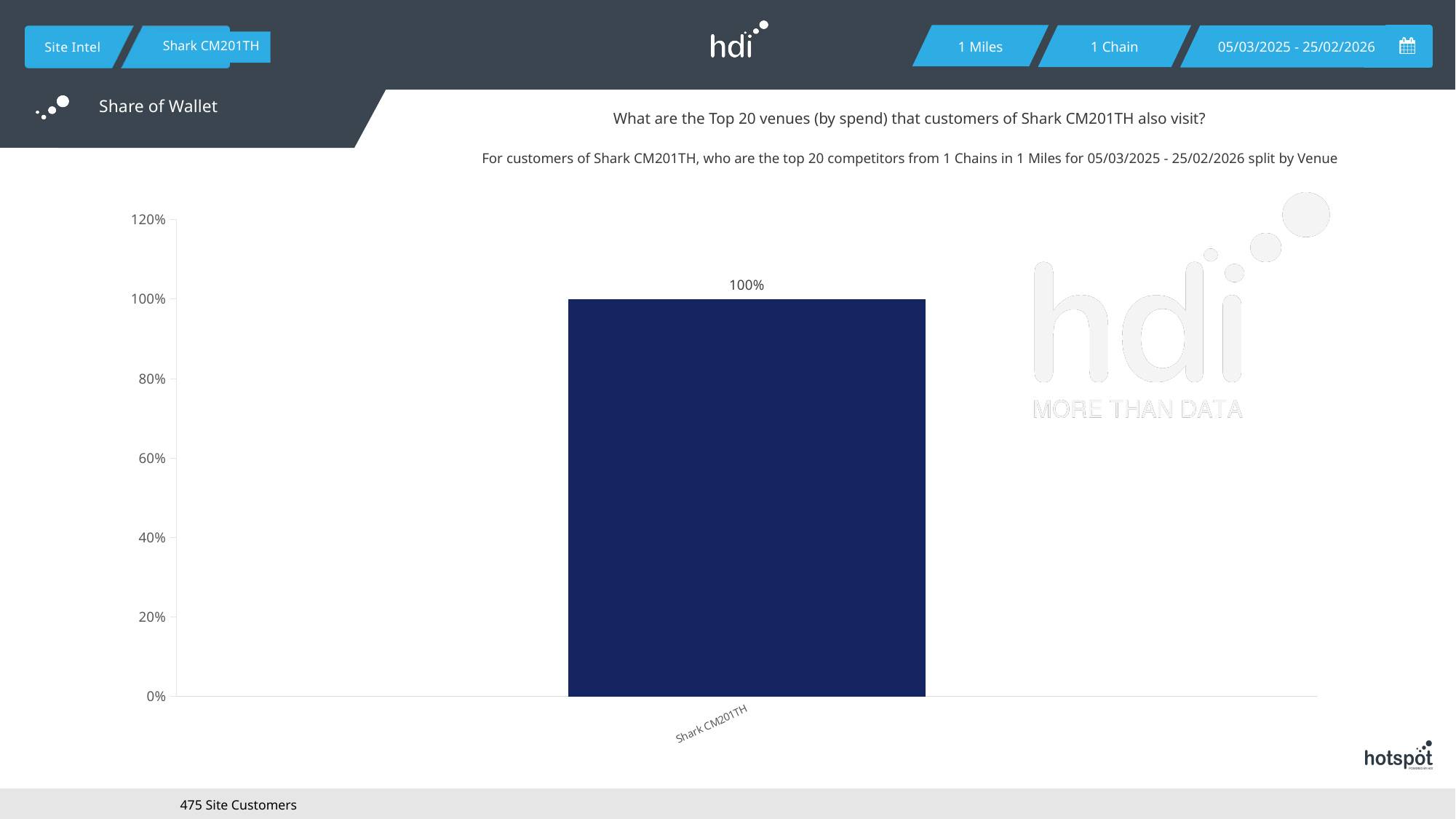
Which category has the highest value in the chart? Shark CM201TH What is the label of the only category on the x axis? Shark CM201TH How many bars are plotted in the chart? 1 Is the value for Shark CM201TH greater or less than 80%? greater What is the value shown for Shark CM201TH? 100% What kind of chart is shown on the slide? bar chart What is the highest value shown on the vertical axis? 120% Is the value for Shark CM201TH greater or less than 120%? less